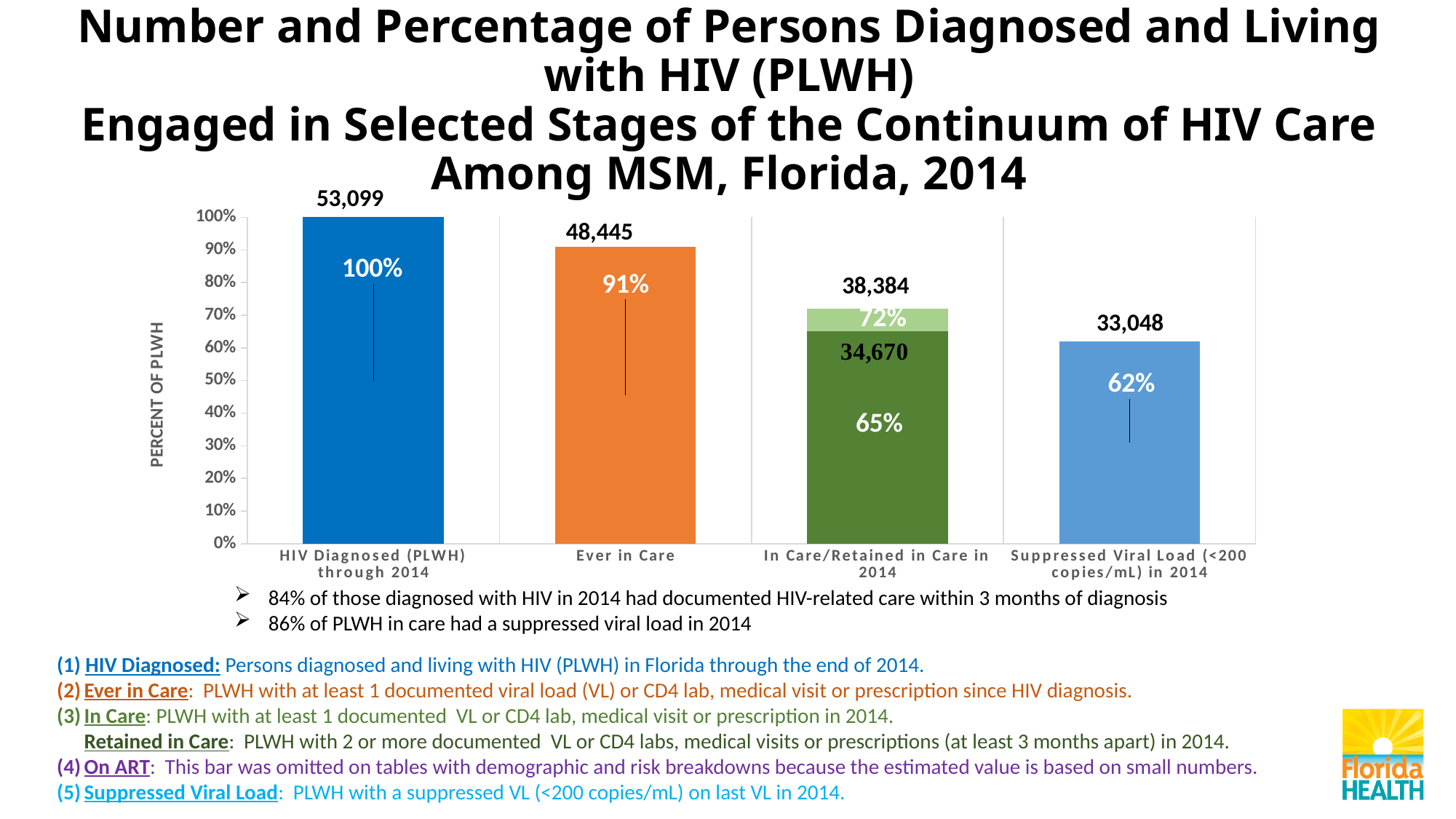
Do the percentages rise or fall moving from left to right across the stages? fall What number is printed above the Suppressed Viral Load (<200 copies/mL) in 2014 bar? 33,048 What number is printed above the bar for HIV Diagnosed (PLWH) through 2014? 53,099 How many stages of the continuum of care are shown on the x axis? 4 What is the difference in number of persons between HIV Diagnosed (53,099) and Ever in Care (48,445)? 4,654 What number is printed for In Care (the top of the In Care/Retained in Care in 2014 bar)? 38,384 Which stage has the highest number of persons? HIV Diagnosed (PLWH) through 2014 Which stage has the lowest percentage of PLWH? Suppressed Viral Load (<200 copies/mL) in 2014 What percentage is shown on the Ever in Care bar? 91% What is the difference in percentage points between HIV Diagnosed (100%) and Suppressed Viral Load (62%)? 38% Which is larger: the number Ever in Care or the number with Suppressed Viral Load in 2014? Ever in Care What percentage is shown for Retained in Care (the dark green portion of the In Care/Retained in Care in 2014 bar)? 65%